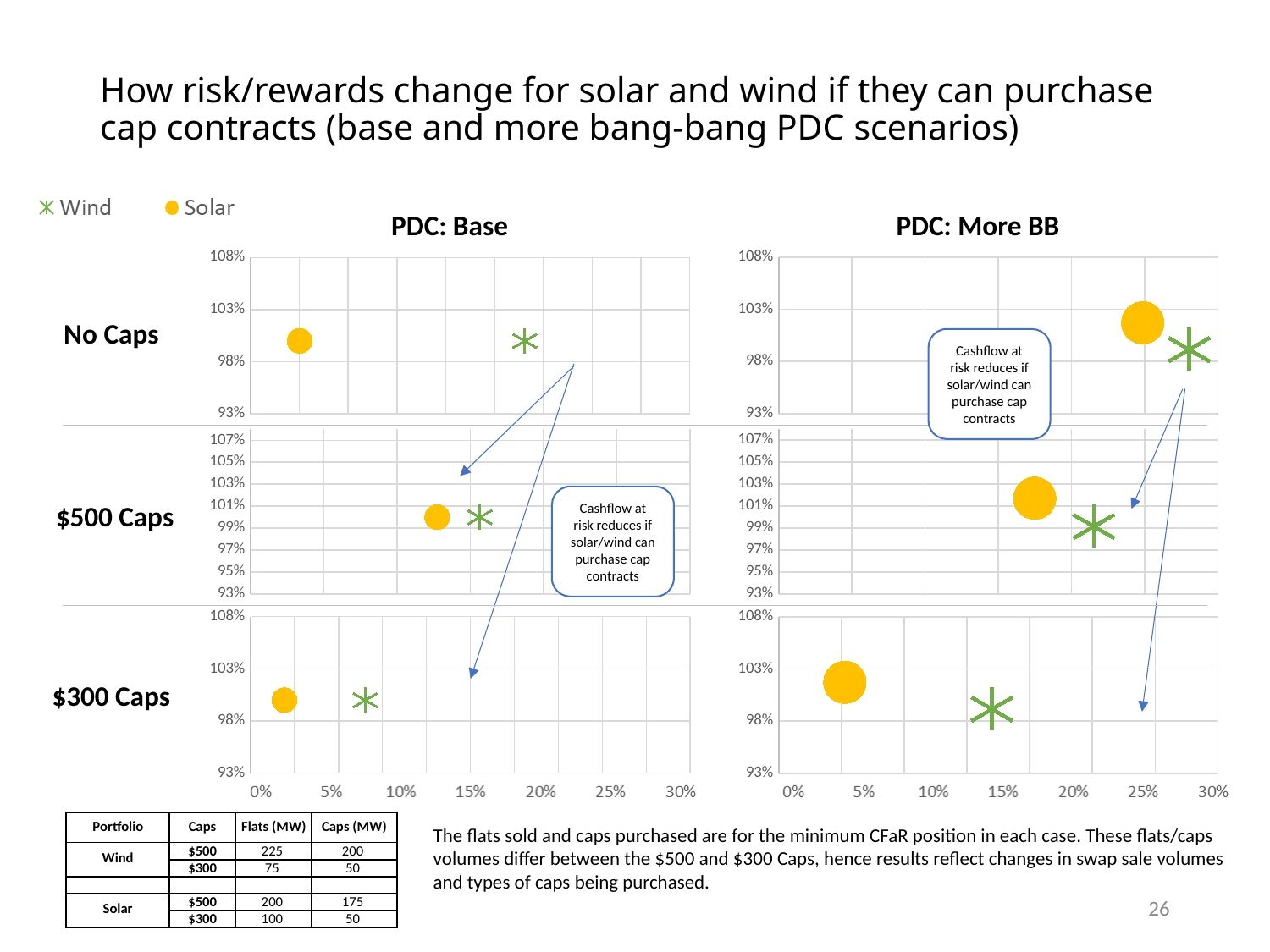
In the PDC: Base, $300 Caps chart, is the x-axis value for Wind greater or less than 10%? less In the PDC: Base, No Caps chart, is the x-axis value for Solar greater or less than 5%? less In the PDC: More BB, $300 Caps chart, which series has the larger x-axis value, Wind or Solar? Wind In the PDC: Base, No Caps chart, is the x-axis value for Wind greater or less than 15%? greater How many data points are plotted in the PDC: Base, $500 Caps chart? 2 In the PDC: Base, No Caps chart, which series has the larger x-axis value, Wind or Solar? Wind What are the two series named in the legend? Wind and Solar In the PDC: More BB, $300 Caps chart, which series has the higher y-axis value, Wind or Solar? Solar How many series does the legend list for the charts? 2 What kind of chart is used in the PDC: Base, No Caps panel? scatter chart